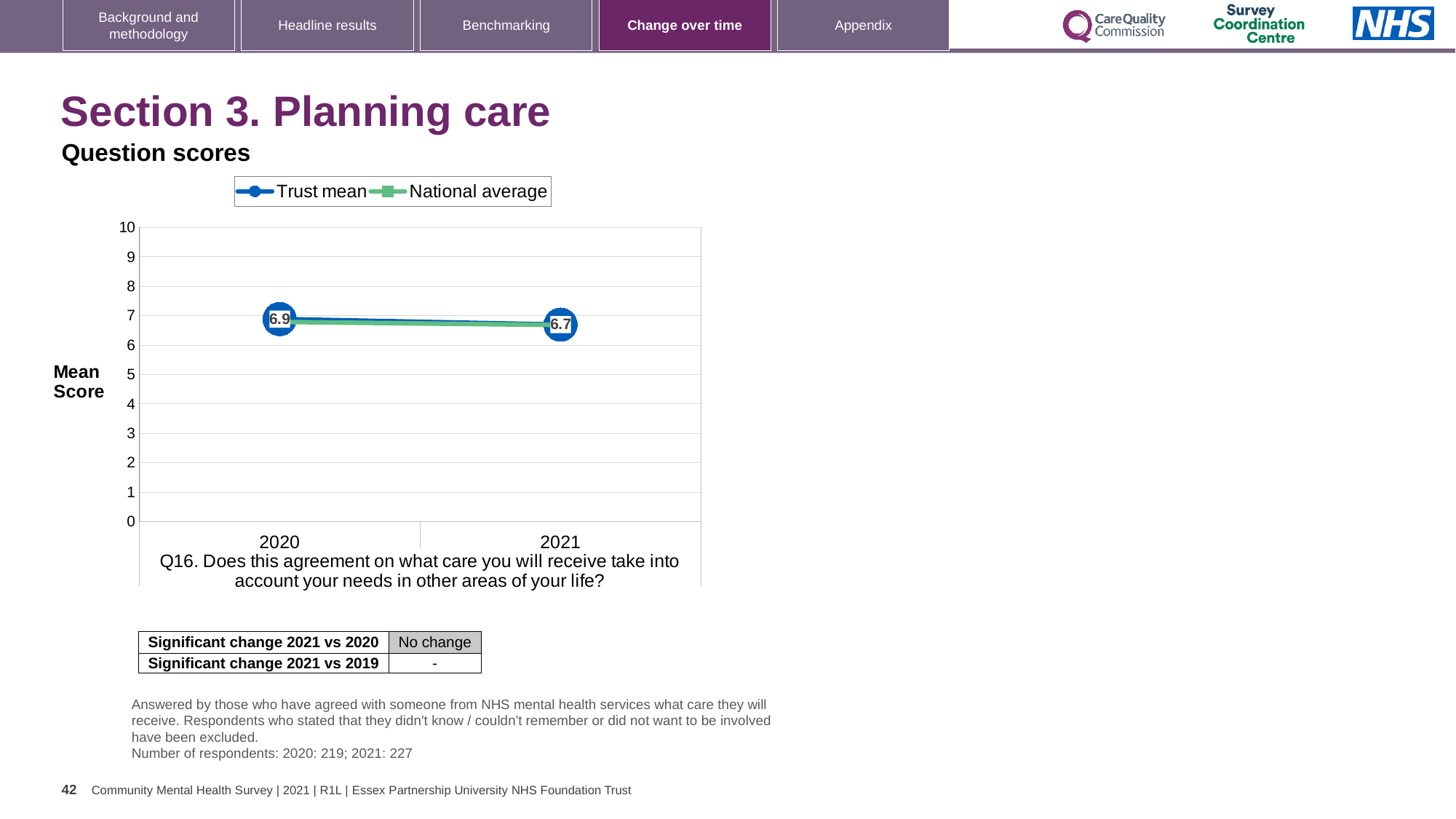
What is the label on the y axis of the chart? Mean Score Is the National average for 2020 greater or less than 6? greater How many series does the legend list? 2 What kind of chart is shown on the slide? Line chart What is the Trust mean score for 2021? 6.7 What is the difference between the Trust mean in 2020 and in 2021? 0.2 Is the Trust mean for 2021 greater or less than 7? less What is the Trust mean score for 2020? 6.9 What are the two series named in the legend? Trust mean and National average Which year has the higher Trust mean, 2020 or 2021? 2020 How many years are plotted on the x axis? 2 Does the Trust mean rise or fall from 2020 to 2021? Fall